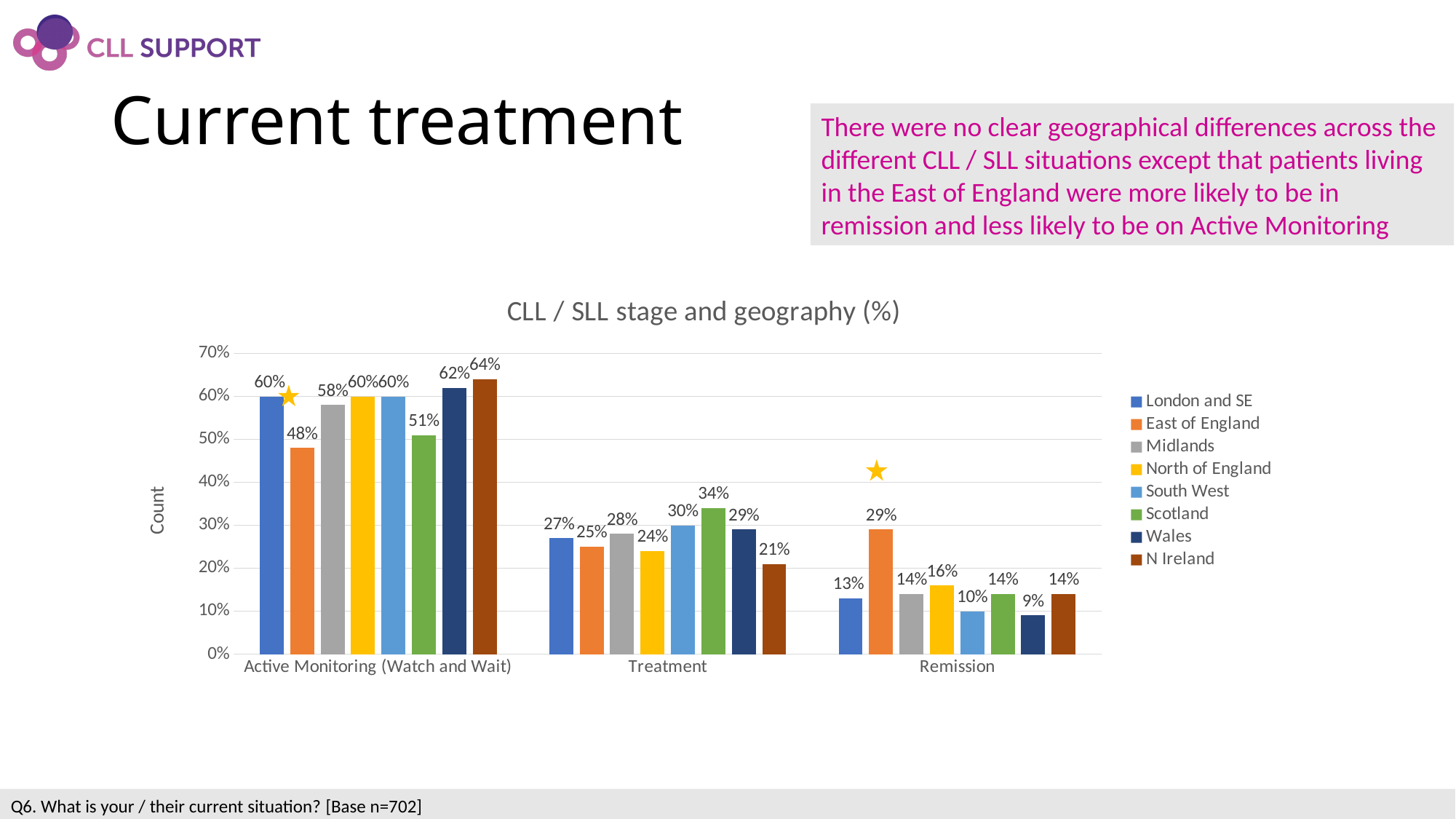
What is the value for Scotland in the Treatment category? 34% What is the value for East of England in the Active Monitoring (Watch and Wait) category? 48% How many series does the legend list? 8 What kind of chart is shown on the slide? Bar chart What is the value for Wales in the Remission category? 9% In the Treatment category, which is larger: South West or North of England? South West What is the difference between N Ireland and East of England in the Active Monitoring (Watch and Wait) category? 16% Which region has the lowest value in the Treatment category? N Ireland How many categories are shown on the x axis? 3 Which region has the lowest value in the Remission category? Wales What is the value for East of England in the Remission category? 29% Which region has the highest value in the Active Monitoring (Watch and Wait) category? N Ireland